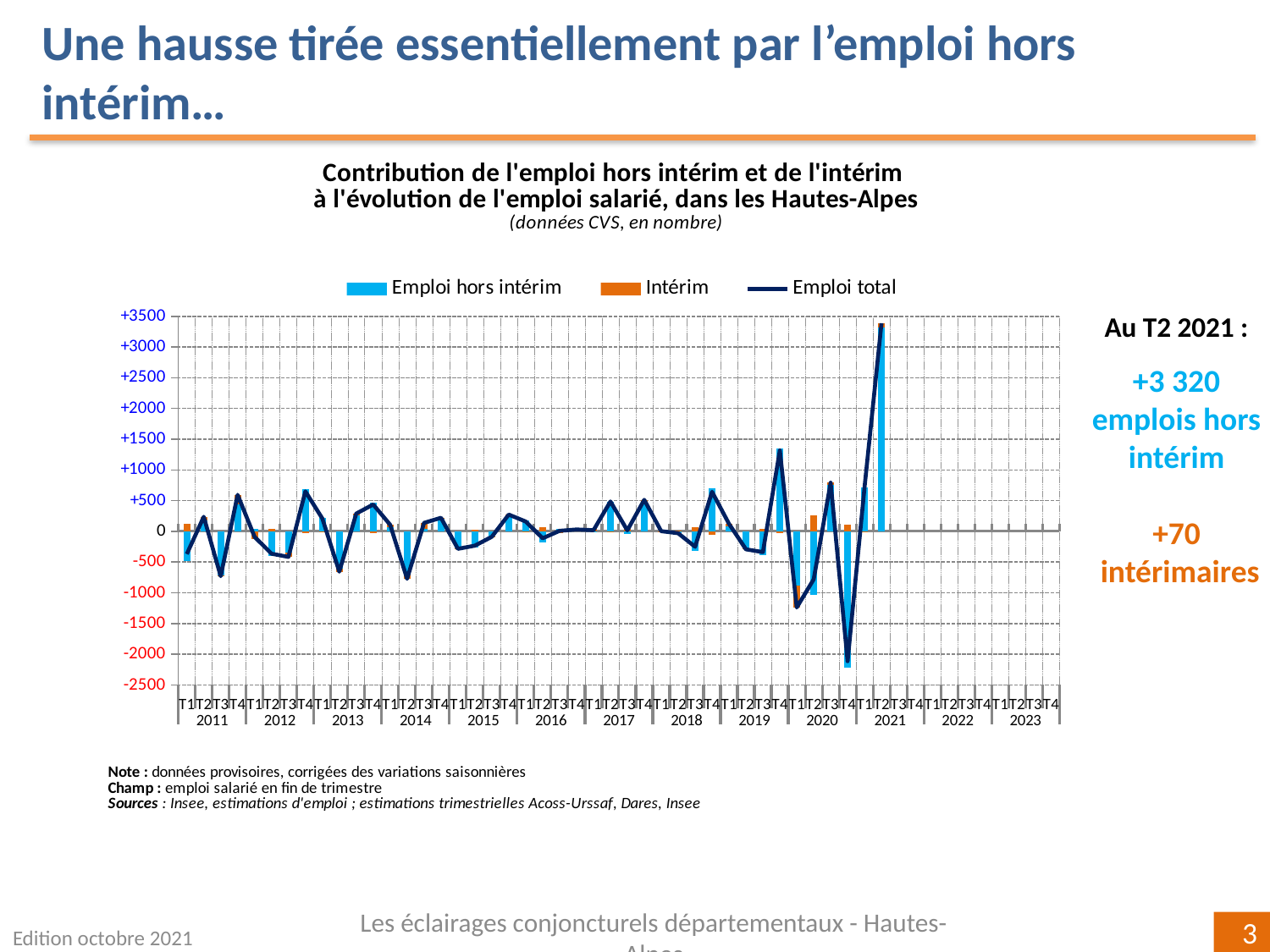
Is the value for Emploi hors intérim at T2 2021 greater or less than +3000? greater What is the value for Intérim at T2 2021? +70 What colour are the Intérim bars in the chart? Orange What is the value for Emploi hors intérim at T2 2021? +3 320 Is the value for Emploi total at T4 2020 greater or less than -1500? less What kind of chart is shown on the slide? A combined bar and line chart At T2 2021, which is larger: Emploi hors intérim or Intérim? Emploi hors intérim In which quarter does the Emploi total line reach its highest value? T2 2021 How many series does the chart legend list? 3 Is the value for Emploi total at T3 2019 greater or less than +1000? less What is the difference between Emploi hors intérim and Intérim at T2 2021? 3 250 In which quarter does the Emploi total line reach its lowest value? T4 2020